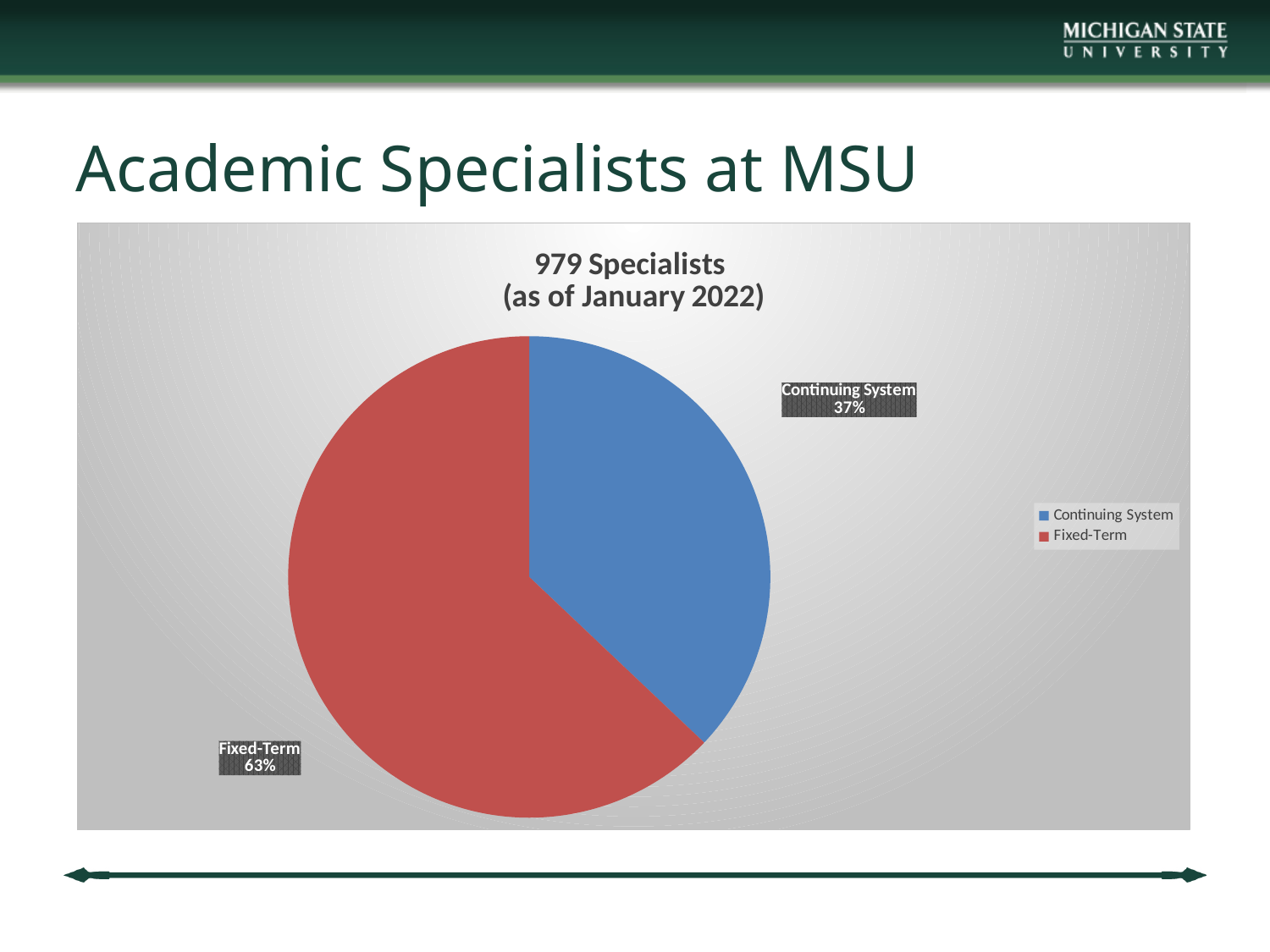
What share of the pie is Fixed-Term? 63% Which slice of the pie is the smallest? Continuing System What share of the pie is Continuing System? 37% Which slice of the pie is the largest? Fixed-Term How many entries does the legend list? 2 How many slices does the pie chart have? 2 What kind of chart is shown on the slide? pie chart What is the title of the chart? 979 Specialists (as of January 2022) Which is larger, the Fixed-Term slice or the Continuing System slice? Fixed-Term What is the difference in percentage points between the Fixed-Term and Continuing System slices? 26 What colour is the Fixed-Term slice? red